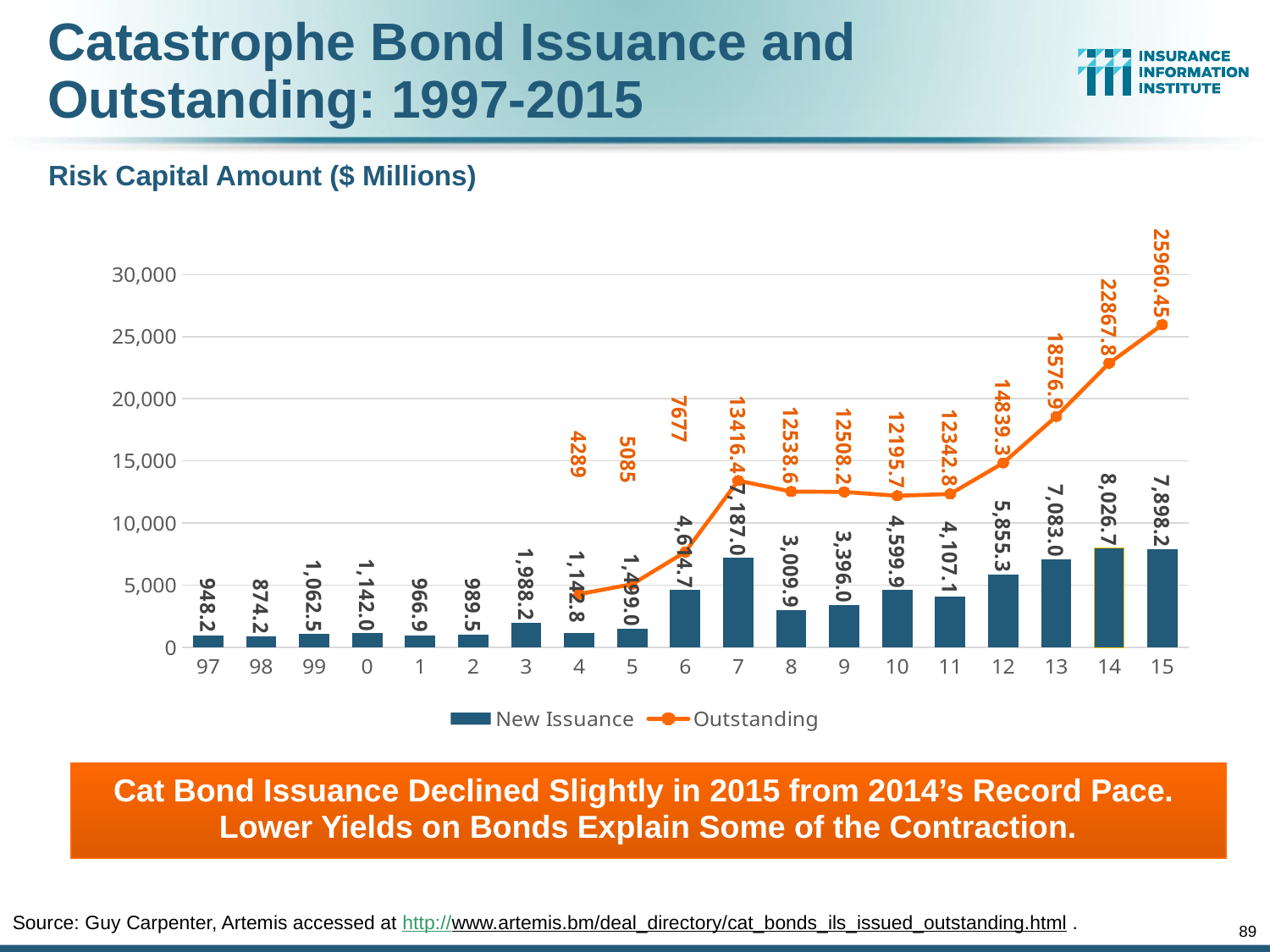
What is the Outstanding value for 15? 25960.45 How many series does the legend list? 2 Which has the larger New Issuance value, 7 or 13? 7 Which year has the lowest New Issuance value? 98 What is the Outstanding value for 7? 13416.4 How many years are shown on the x axis? 19 What is the difference between the New Issuance values for 14 and 15? 128.5 What kind of chart is shown? Bar chart with a line series What is the New Issuance value for 14? 8,026.7 Does the Outstanding line rise or fall from 12 to 15? Rise Which year has the highest New Issuance value? 14 What is the difference between the Outstanding values for 15 and 14? 3092.65